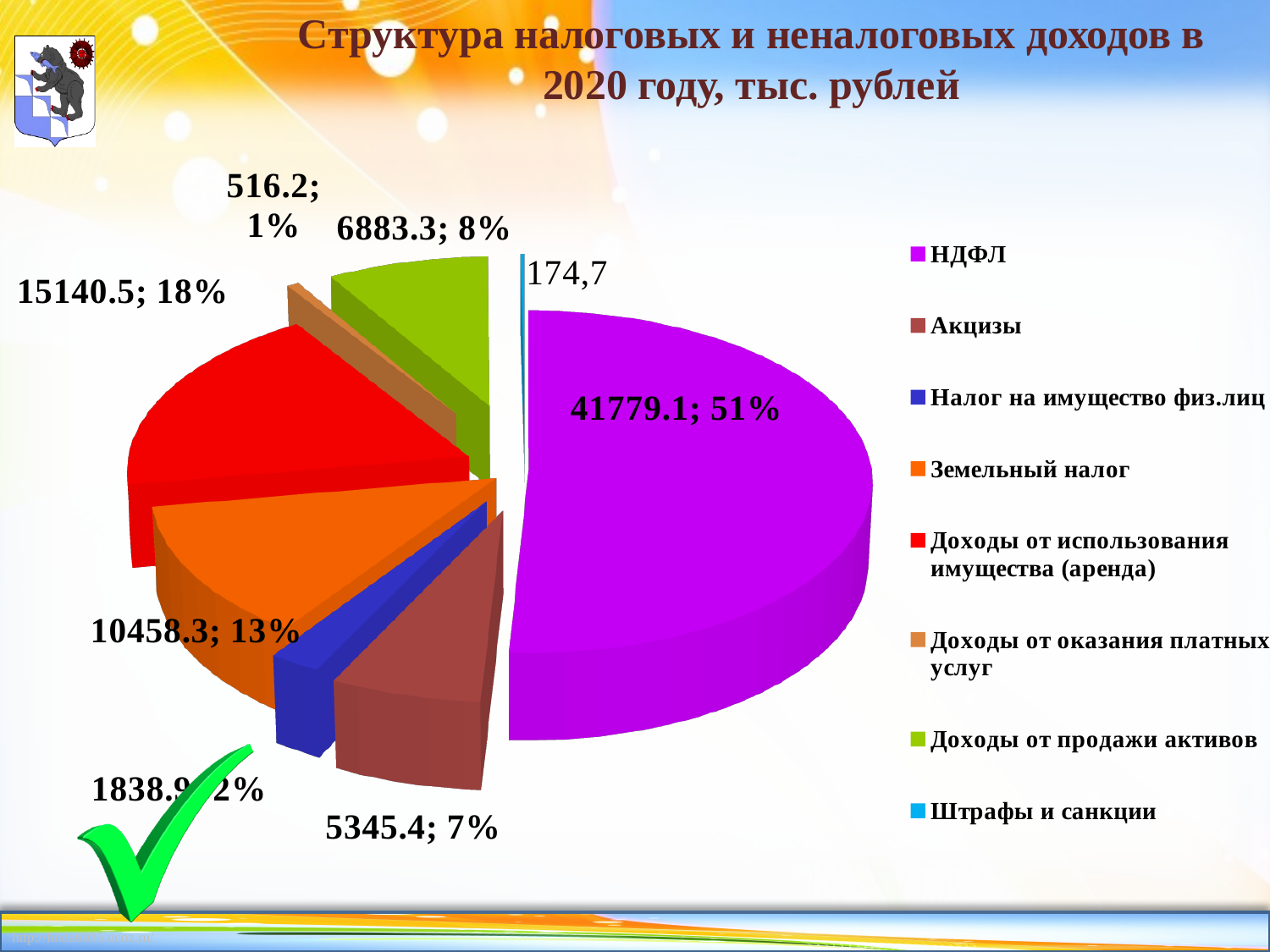
Which category has the largest slice of the pie? НДФЛ What is the title of the chart? Структура налоговых и неналоговых доходов в 2020 году, тыс. рублей What share of the pie does НДФЛ represent? 51% What is the value for НДФЛ? 41779.1 How many categories does the legend list? 8 What is the value for Штрафы и санкции? 174,7 Which is larger, the value for Акцизы or the value for Доходы от продажи активов? Доходы от продажи активов What kind of chart is shown on the slide? Pie chart What is the difference between the values for НДФЛ and Доходы от использования имущества (аренда)? 26638.6 Which category has the smallest slice of the pie? Штрафы и санкции What share of the pie does Доходы от использования имущества (аренда) represent? 18% What is the value for Земельный налог? 10458.3